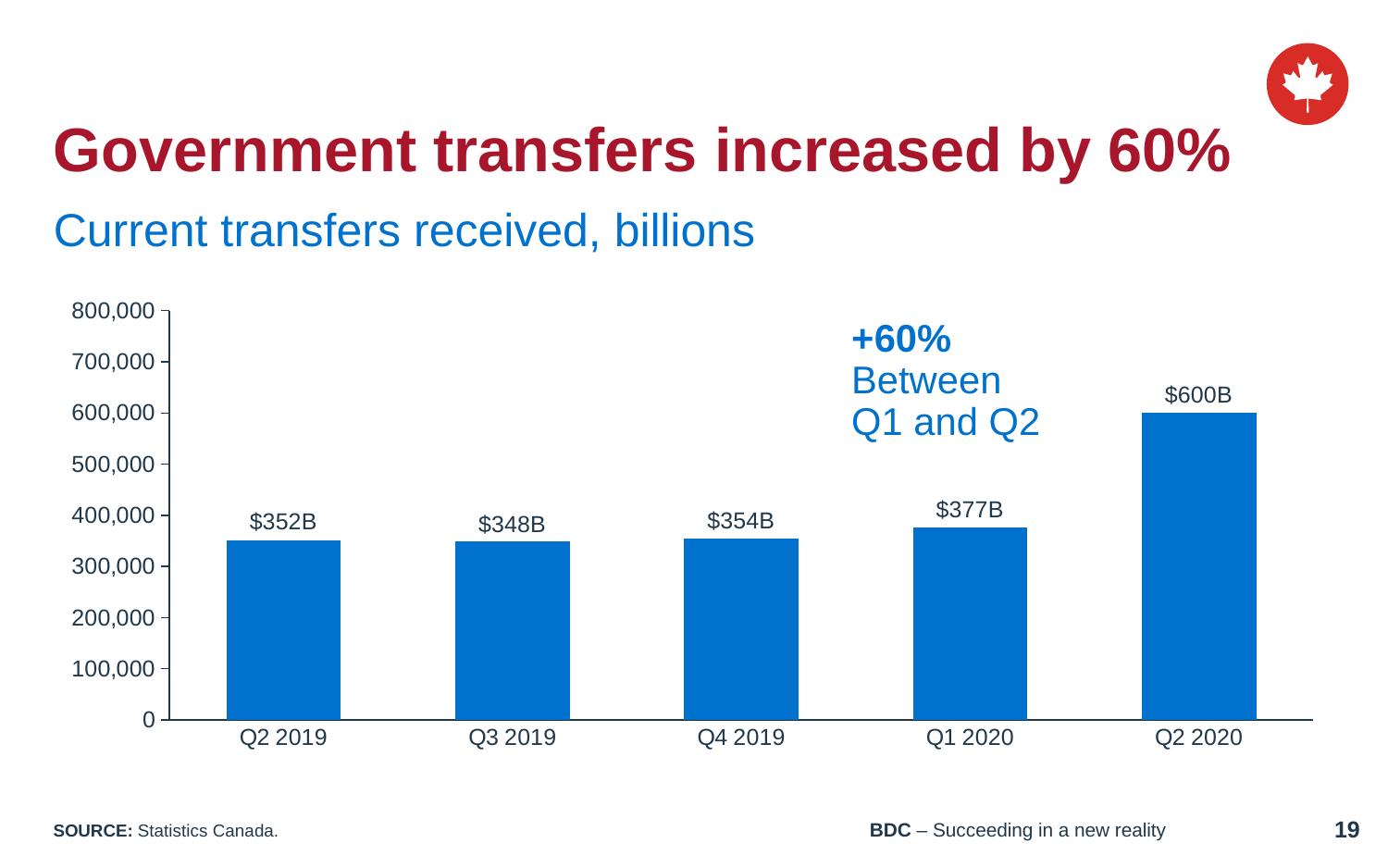
Is the value for Q2 2020 greater or less than 500,000 on the axis? greater Which is larger, the value for Q4 2019 or the value for Q3 2019? Q4 2019 What is the difference between the values for Q2 2020 and Q1 2020? $223B What kind of chart is shown on the slide? Bar chart What percentage increase is annotated between Q1 and Q2? +60% Which quarter has the lowest value? Q3 2019 What is the value for Q2 2020? $600B What is the subtitle describing the chart? Current transfers received, billions How many quarters are shown on the x axis? 5 What is the value for Q2 2019? $352B Which quarter has the highest value? Q2 2020 What is the value for Q1 2020? $377B